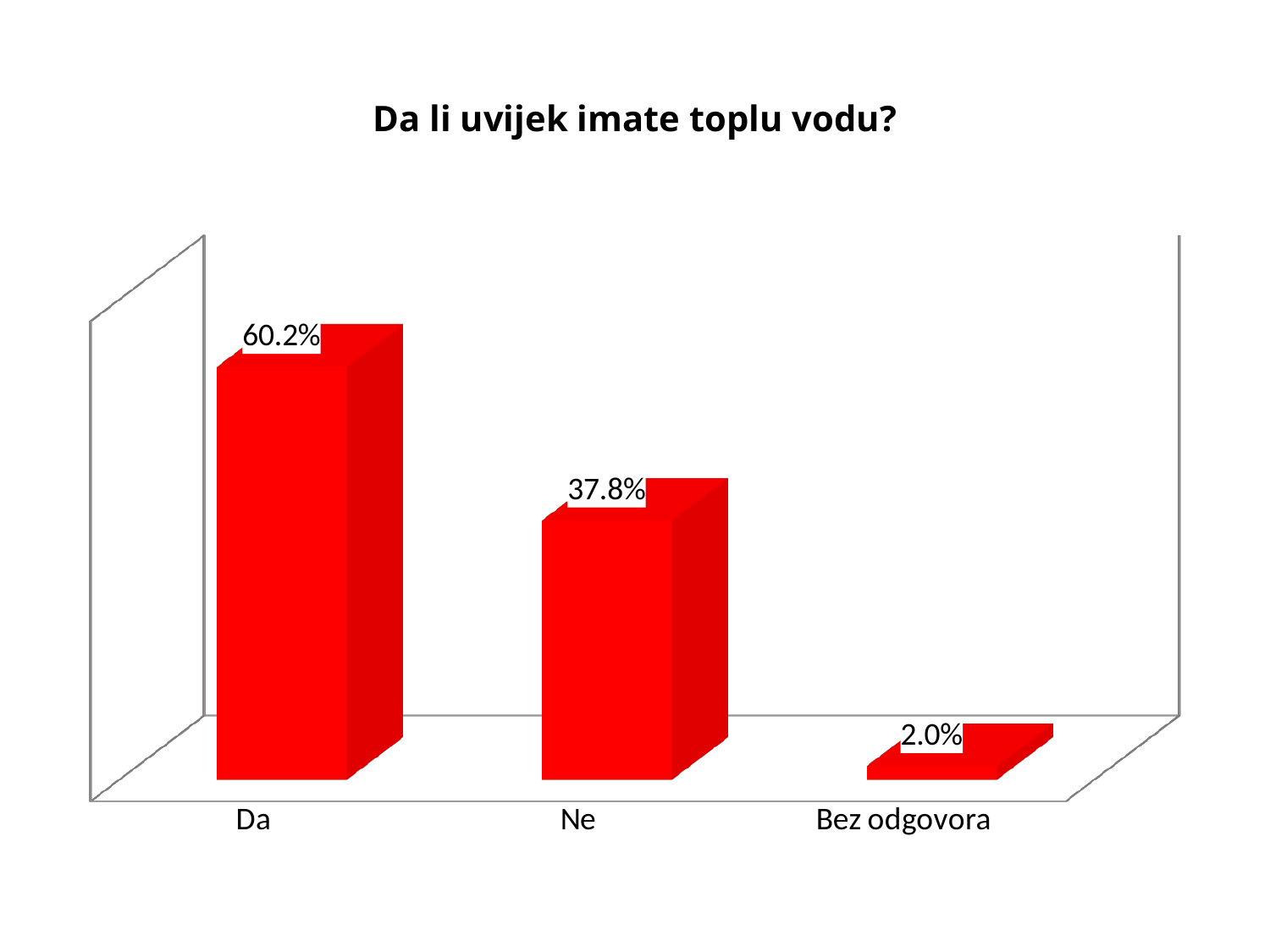
What kind of chart is shown on the slide? Bar chart What is the title of the chart? Da li uvijek imate toplu vodu? What is the value for "Da"? 60.2% What is the difference between the values for "Da" and "Ne"? 22.4% What is the value for "Ne"? 37.8% What is the value for "Bez odgovora"? 2.0% How many categories are shown on the x axis? 3 What is the difference between the values for "Ne" and "Bez odgovora"? 35.8% Which category has the lowest value? Bez odgovora Which is larger, the value for "Da" or the value for "Ne"? Da Do the values rise or fall from left to right along the x axis? Fall Which category has the highest value? Da